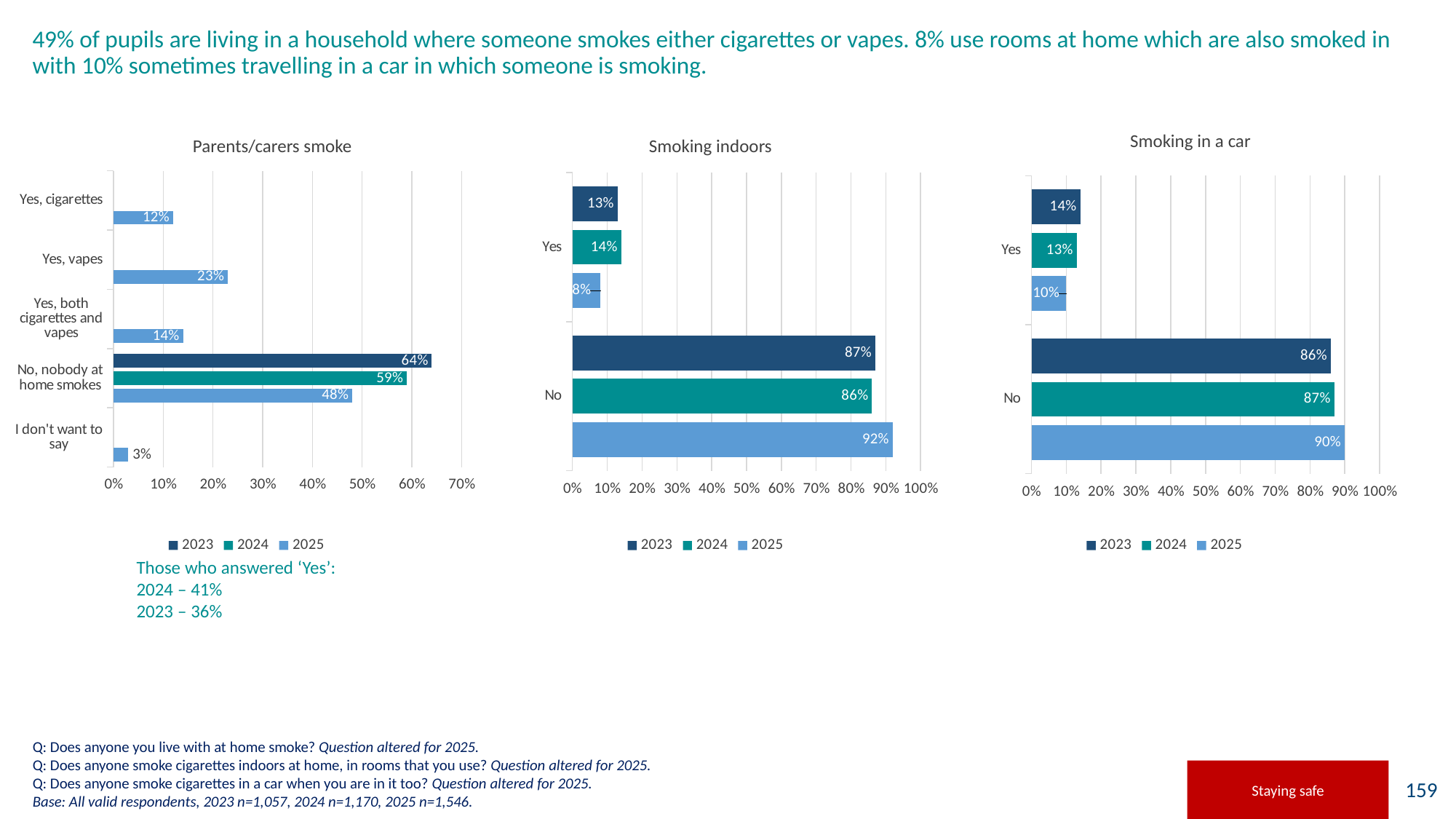
In the 'Smoking indoors' chart, what is the difference between the 2024 and 2025 values for 'Yes'? 6% In the 'Smoking indoors' chart, which year has the highest value for 'No'? 2025 In the 'Parents/carers smoke' chart, what is the 2023 value for 'No, nobody at home smokes'? 64% How many series does the legend of the 'Smoking in a car' chart list? 3 In the 'Parents/carers smoke' chart, which category has the lowest 2025 value? I don't want to say In the 'Parents/carers smoke' chart, how many categories are shown on the vertical axis? 5 In the 'Smoking indoors' chart, what is the 2025 value for 'Yes'? 8% In the 'Smoking in a car' chart, what is the 2025 value for 'No'? 90% In the 'Parents/carers smoke' chart, what is the difference between the 2023 and 2025 values for 'No, nobody at home smokes'? 16% In the 'Parents/carers smoke' chart, what is the 2025 value for 'Yes, vapes'? 23% What type of chart is the 'Smoking indoors' chart? Bar chart In the 'Smoking in a car' chart, is the 2023 value for 'Yes' larger or smaller than the 2025 value for 'Yes'? larger